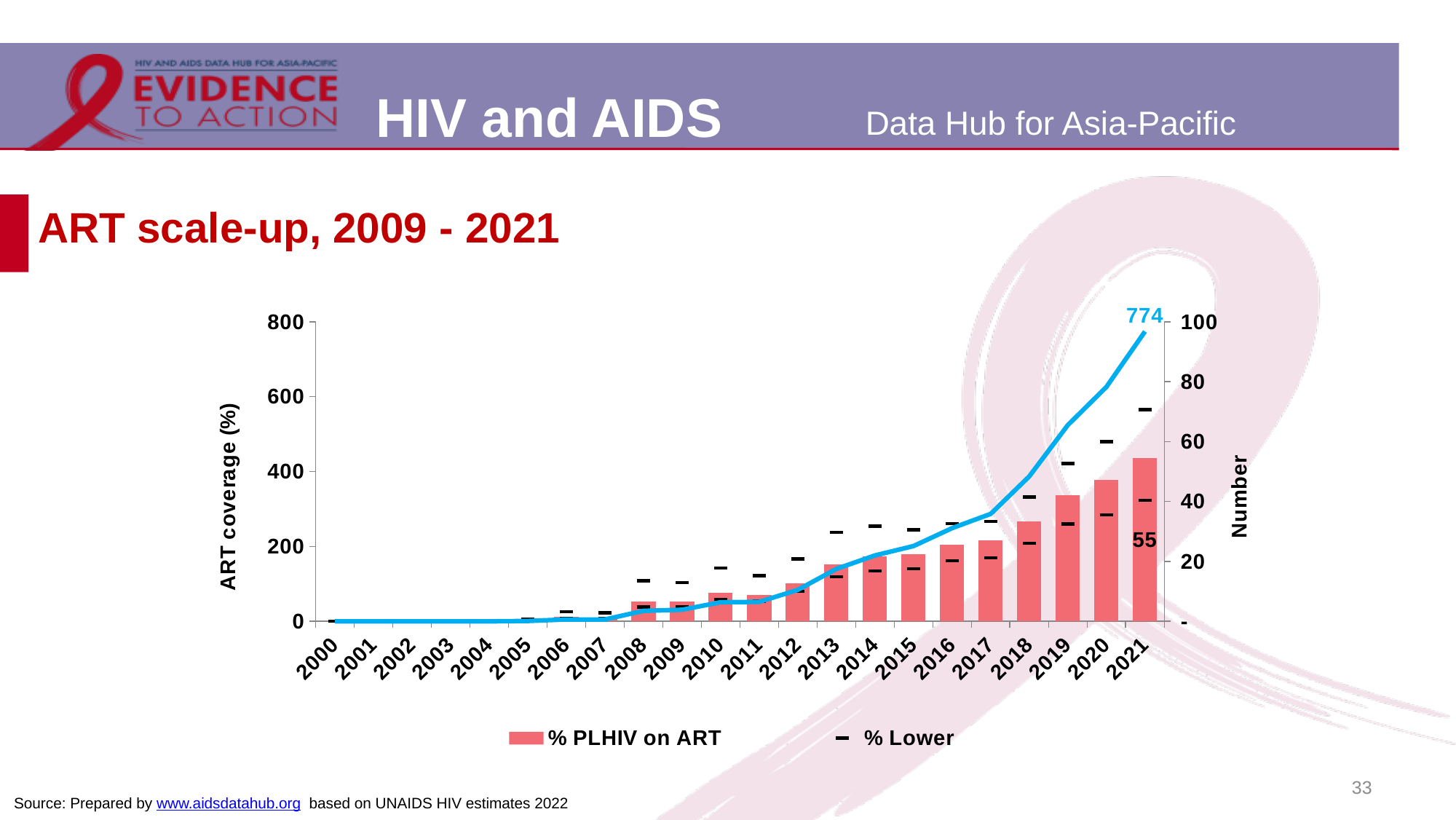
What kind of chart is this? A bar chart combined with a line Do the % PLHIV on ART bars rise or fall from 2008 to 2021? Rise What is the title of the right vertical axis? Number What value is labelled on the blue line at 2021? 774 Which year has the taller % PLHIV on ART bar, 2019 or 2020? 2020 How many series does the legend list? 2 How many years are shown along the x axis? 22 What is the title of the left vertical axis? ART coverage (%) What is the data label on the bar for 2021? 55 Which year has the tallest % PLHIV on ART bar? 2021 On the left axis, is the % PLHIV on ART bar for 2018 greater or less than 200? greater